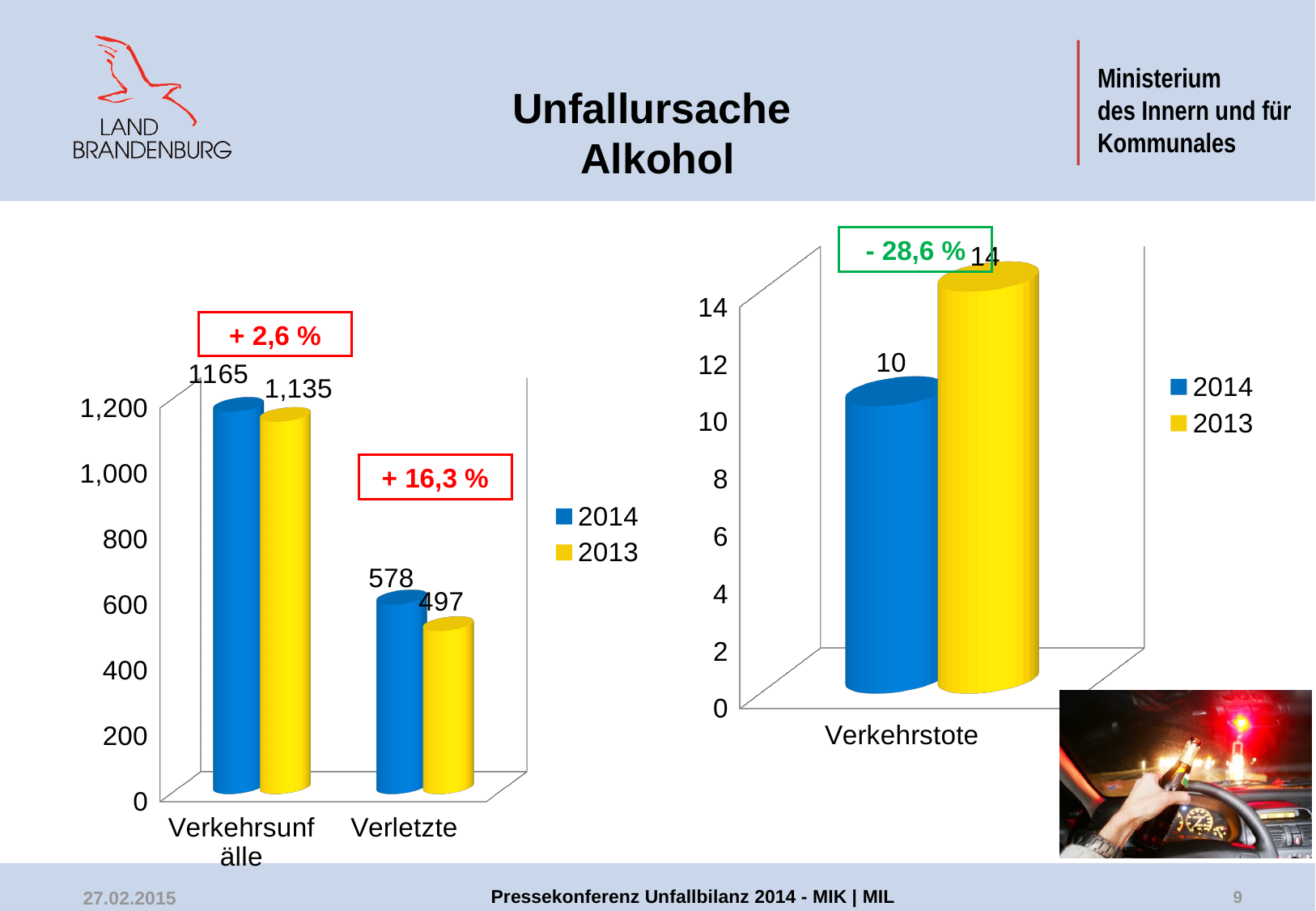
In the left chart, what is the 2014 value for Verkehrsunfälle? 1165 In the left chart, what is the 2013 value for Verkehrsunfälle? 1,135 In the right chart, what is the 2014 value for Verkehrstote? 10 In the left chart, which category has the lowest 2013 value? Verletzte In the left chart, how many categories are shown on the x axis? 2 What kind of chart is the right chart? bar chart In the left chart, what is the 2014 value for Verletzte? 578 In the right chart, what is the 2013 value for Verkehrstote? 14 In the right chart, how many series does the legend list? 2 In the left chart, what is the difference between the 2014 and 2013 values for Verletzte? 81 In the left chart, what is the 2013 value for Verletzte? 497 In the right chart, which series has the larger value for Verkehrstote, 2014 or 2013? 2013